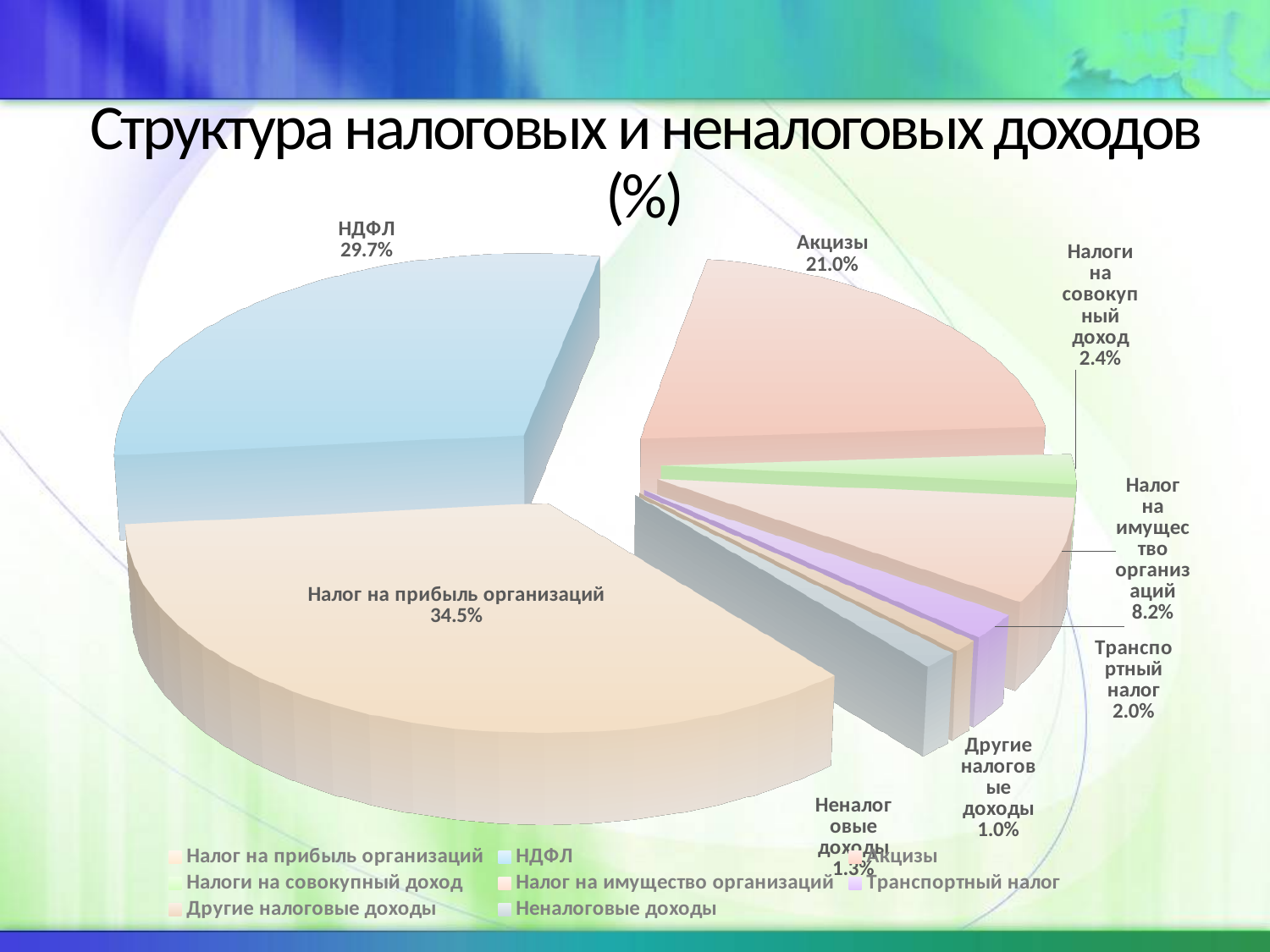
Which category has the smallest share in the pie chart? Другие налоговые доходы What is the share of Акцизы in the pie chart? 21.0% What is the share of НДФЛ in the pie chart? 29.7% What is the share of Транспортный налог in the pie chart? 2.0% What is the share of Налог на прибыль организаций in the pie chart? 34.5% What kind of chart is shown on the slide? Pie chart What is the difference in percentage points between Налог на прибыль организаций and НДФЛ? 4.8 Which is larger: the share of Налоги на совокупный доход or the share of Транспортный налог? Налоги на совокупный доход How many slices does the pie chart have? 8 What is the title of the chart on the slide? Структура налоговых и неналоговых доходов (%) Which category has the largest share in the pie chart? Налог на прибыль организаций What is the share of Налог на имущество организаций in the pie chart? 8.2%